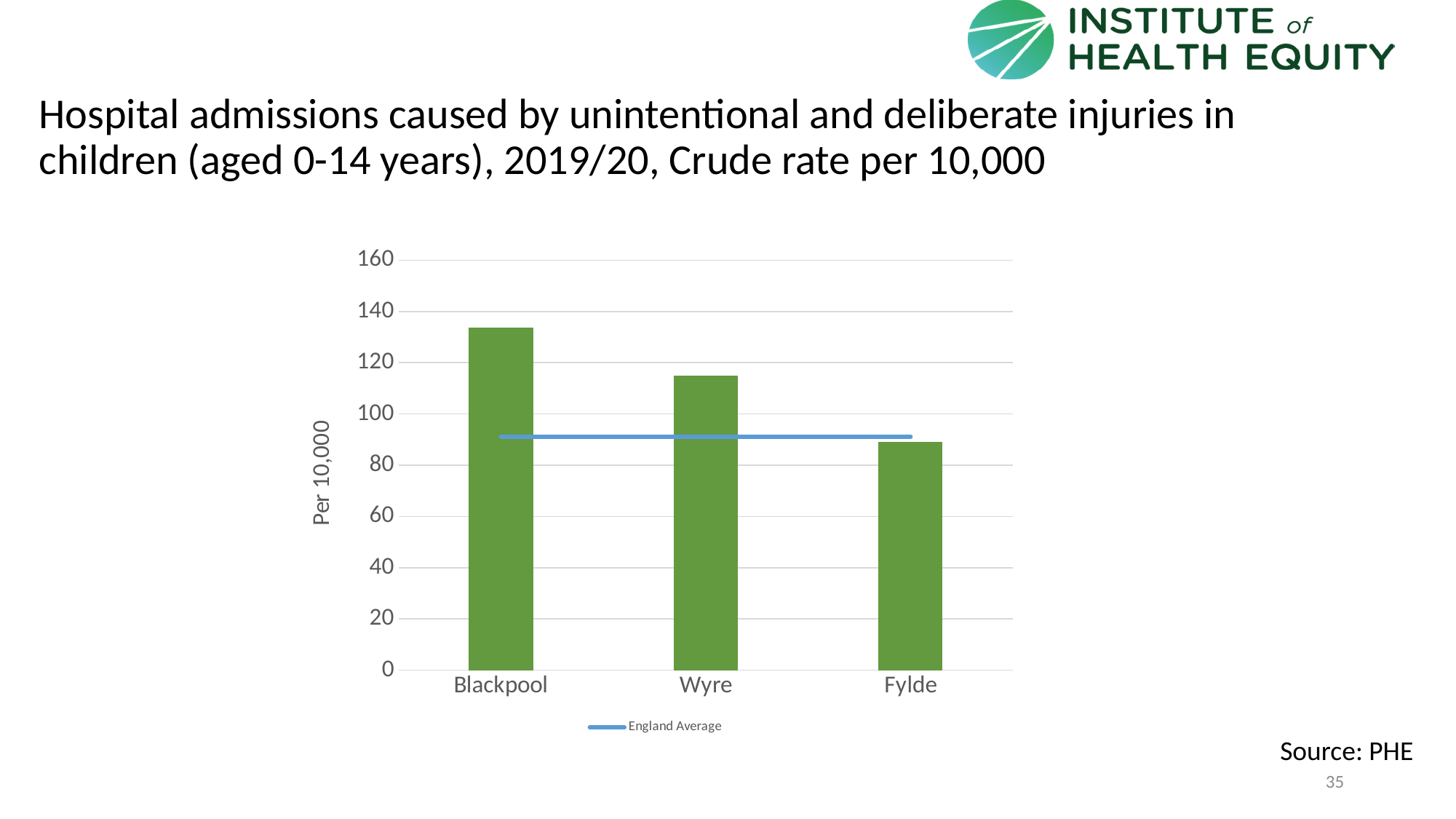
Is the value for Blackpool greater or less than 140? less Which is larger, the value for Blackpool or the value for Wyre? Blackpool What kind of chart is shown on the slide? bar chart Is the England Average line greater or less than 100? less Is the value for Blackpool greater or less than 120? greater Which area has the highest hospital admission rate in the chart? Blackpool Which area has the lowest hospital admission rate in the chart? Fylde What is the label on the y axis of the chart? Per 10,000 How many areas are shown on the x axis of the chart? 3 Do the bar values rise or fall from left to right across the x axis? fall